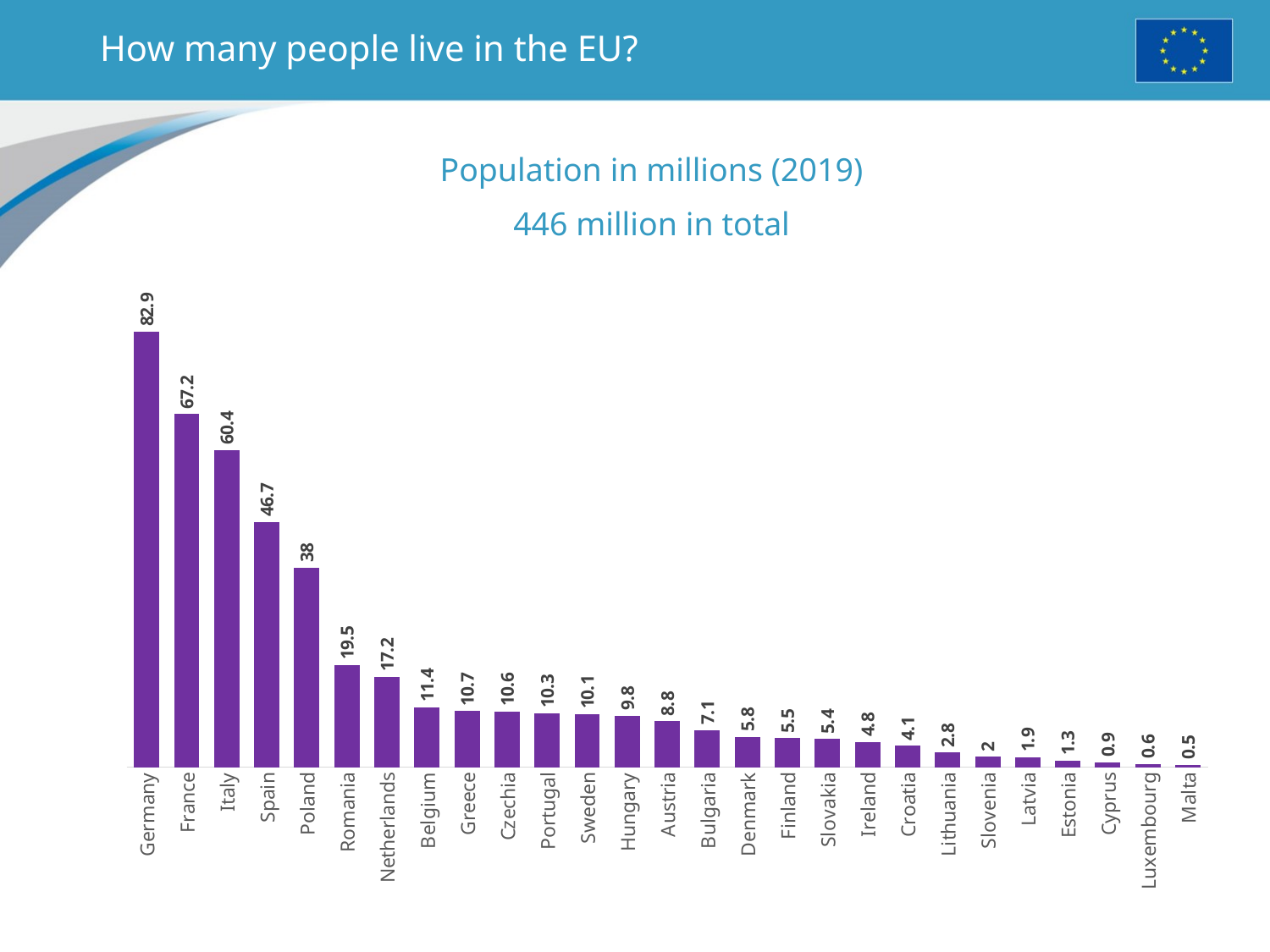
Which has a larger population, Romania or Belgium? Romania Which country has the highest population in the chart? Germany What type of chart is shown on the slide? Bar chart What is the population in millions shown for Slovakia? 5.4 How many countries are shown in the chart? 27 Which has a larger population, Hungary or Bulgaria? Hungary Which country has the lowest population in the chart? Malta What is the population in millions shown for Germany? 82.9 Do the values rise or fall from left to right along the x axis? Fall What is the difference in population (millions) between Spain and Poland? 8.7 What is the difference in population (millions) between France and Italy? 6.8 What is the population in millions shown for Netherlands? 17.2